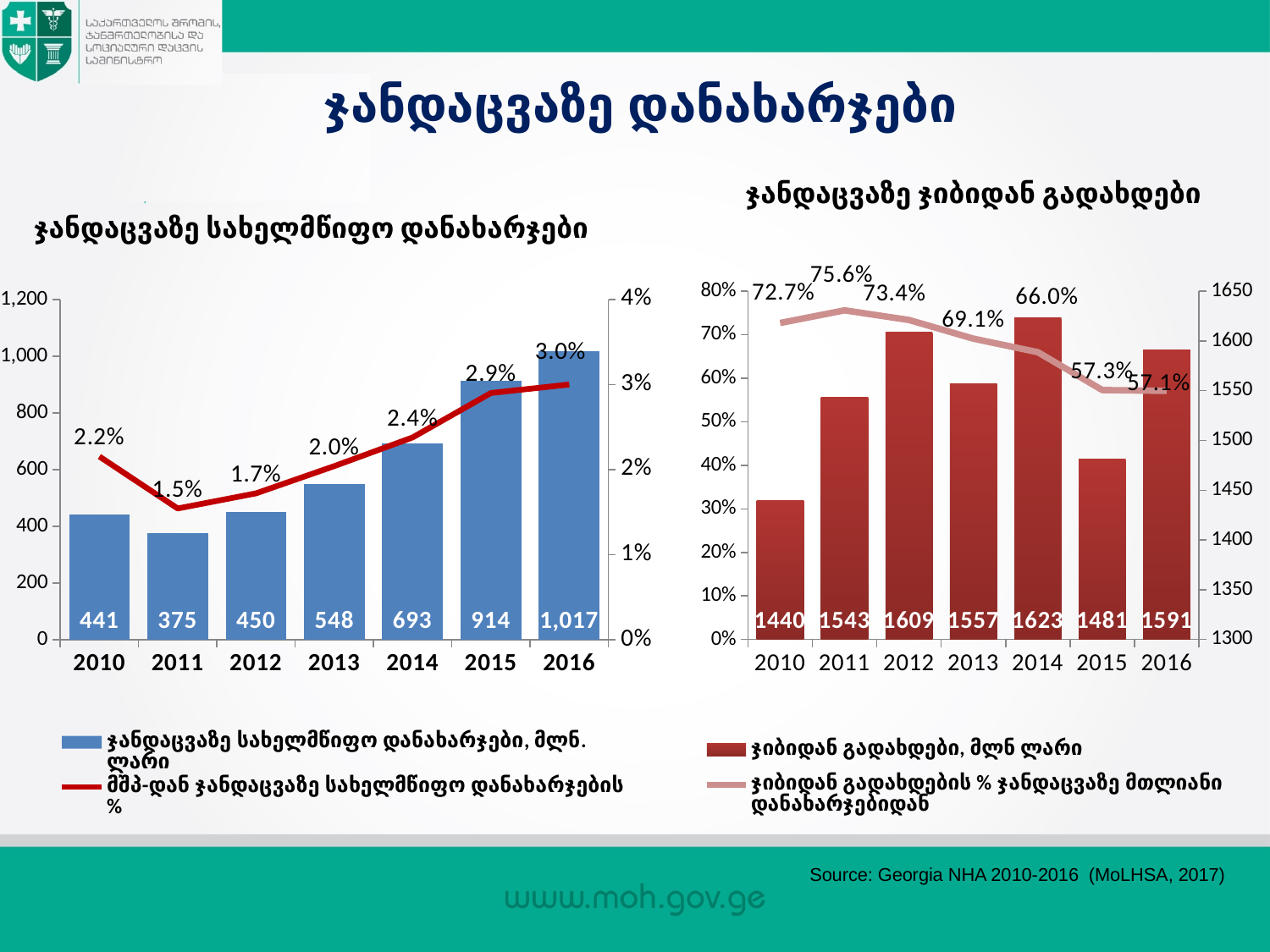
In the right chart, which year has the highest bar? 2014 In the right chart, what is the value of the bar for 2012? 1609 In the right chart, which is larger, the bar for 2013 or the bar for 2015? 2013 How many series does the legend of the right chart list? 2 In the left chart, what is the difference between the bar values for 2016 and 2015? 103 In the left chart, which year has the highest bar? 2016 In the left chart, which year has the lowest bar? 2011 In the right chart, what percentage does the line show for 2011? 75.6% In the left chart, what percentage does the line show for 2014? 2.4% In the left chart, how many years are shown on the x axis? 7 In the right chart, does the line percentage rise or fall from 2011 to 2016? fall In the left chart, what is the value of the bar for 2013? 548